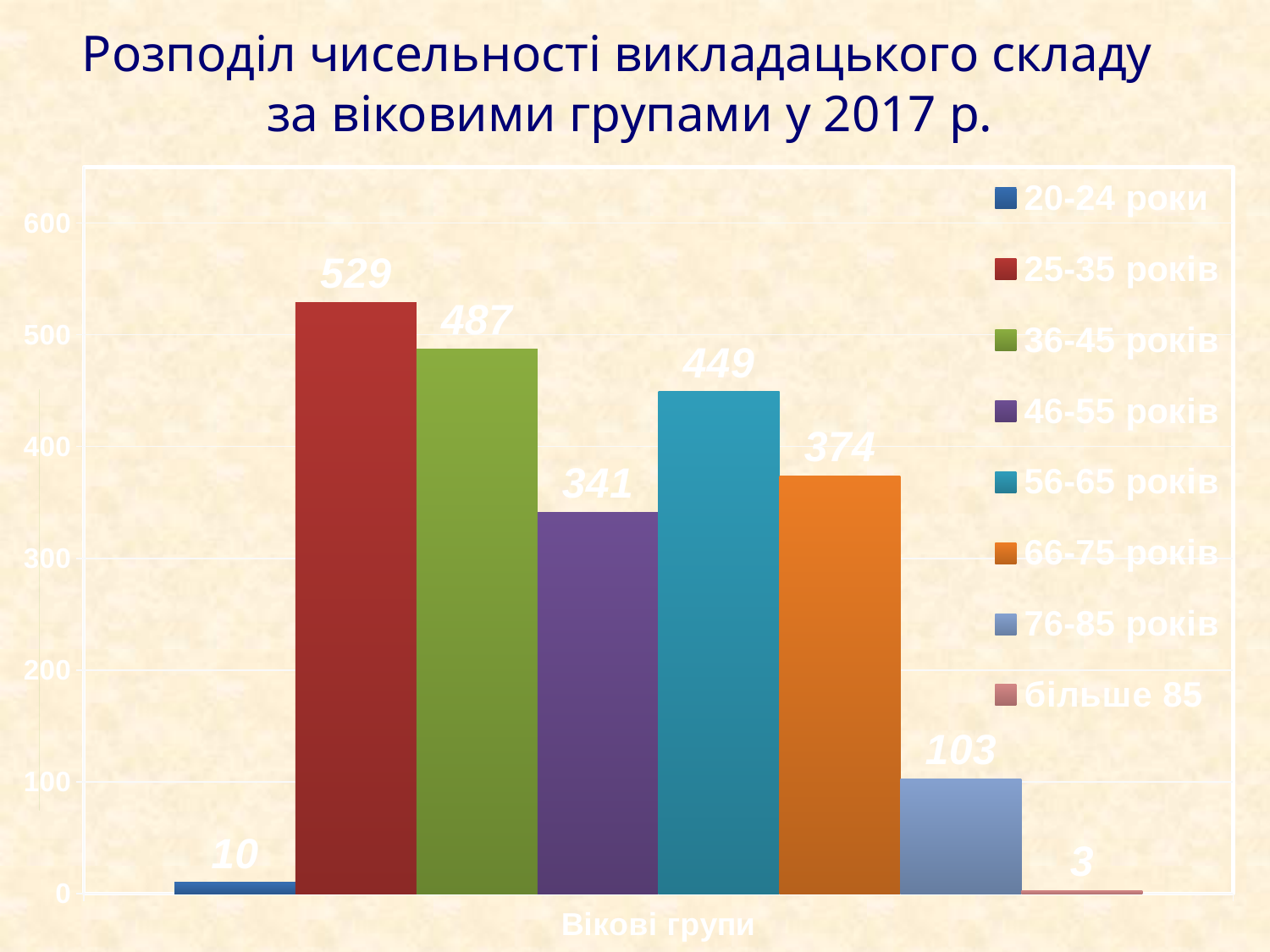
How many age groups are shown in the chart? 8 What is the value for the 25-35 років age group? 529 What is the difference between the values for 36-45 років and 46-55 років? 146 Which is larger, the value for 56-65 років or the value for 66-75 років? 56-65 років What is the x-axis title of the chart? Вікові групи Which age group has the lowest value? більше 85 What is the value for the 56-65 років age group? 449 Is the value for 66-75 років greater or less than 400? less What is the value for the 76-85 років age group? 103 What kind of chart is shown on the slide? bar chart Which age group has the highest value? 25-35 років How many entries does the legend list? 8